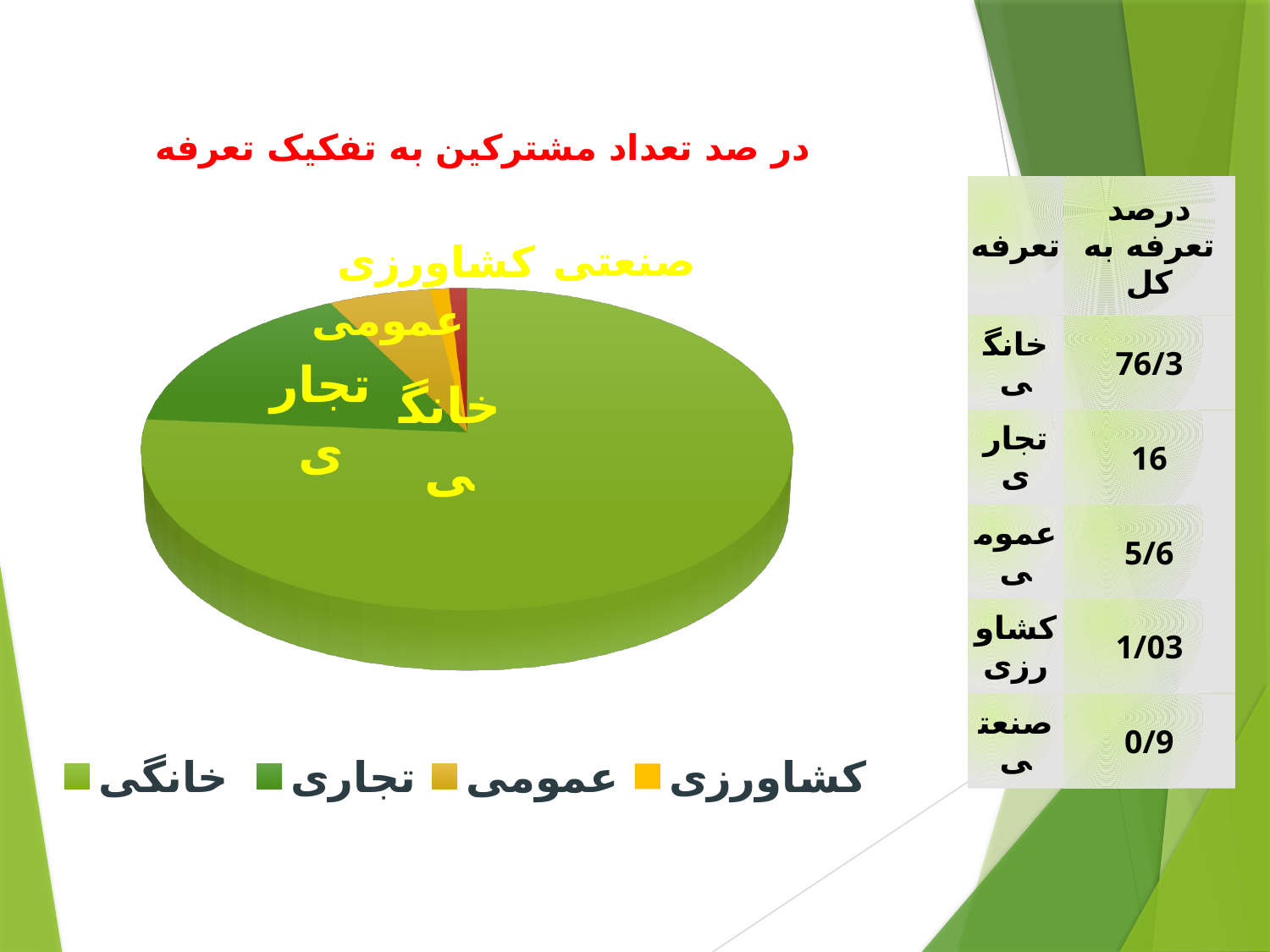
Which tariff category has the smallest share according to the slide? صنعتی Which tariff category has the largest slice of the pie? خانگی Which has the larger share, تجاری or عمومی? تجاری What is the percentage for خانگی shown on the slide? 76/3 What is the percentage for تجاری shown on the slide? 16 What is the percentage for عمومی shown on the slide? 5/6 What is the title of the chart? در صد تعداد مشترکین به تفکیک تعرفه What kind of chart is shown on the slide? pie chart What is the difference between the percentages for خانگی and تجاری? 60/3 How many entries are listed in the legend below the pie chart? 4 How many slices does the pie chart have? 5 What is the percentage for کشاورزی shown on the slide? 1/03